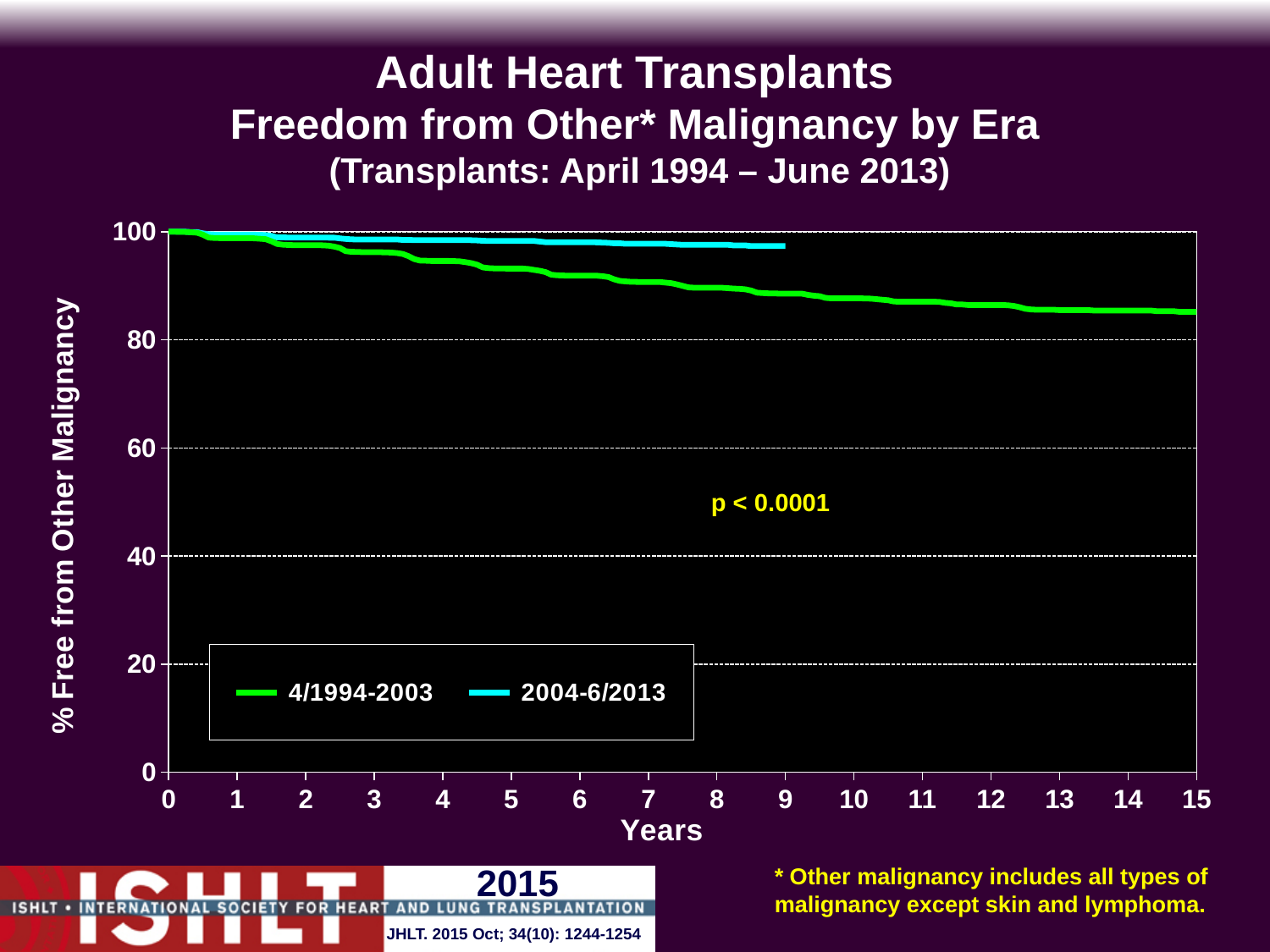
What p-value is printed on the chart? p < 0.0001 Is the value for the 2004-6/2013 series at year 9 greater or less than 80? greater Is the value for the 4/1994-2003 series at year 15 greater or less than 80? greater Which series has the higher % free from other malignancy at year 5, 4/1994-2003 or 2004-6/2013? 2004-6/2013 What kind of chart is shown on the slide? line chart What is the label of the x axis? Years Do the values for the 4/1994-2003 series rise or fall as years increase? fall Is the value for the 4/1994-2003 series at year 10 greater or less than 100? less Which series extends further along the x axis, 4/1994-2003 or 2004-6/2013? 4/1994-2003 How many series does the legend list? 2 What colour is the line for the 2004-6/2013 era? cyan (light blue)